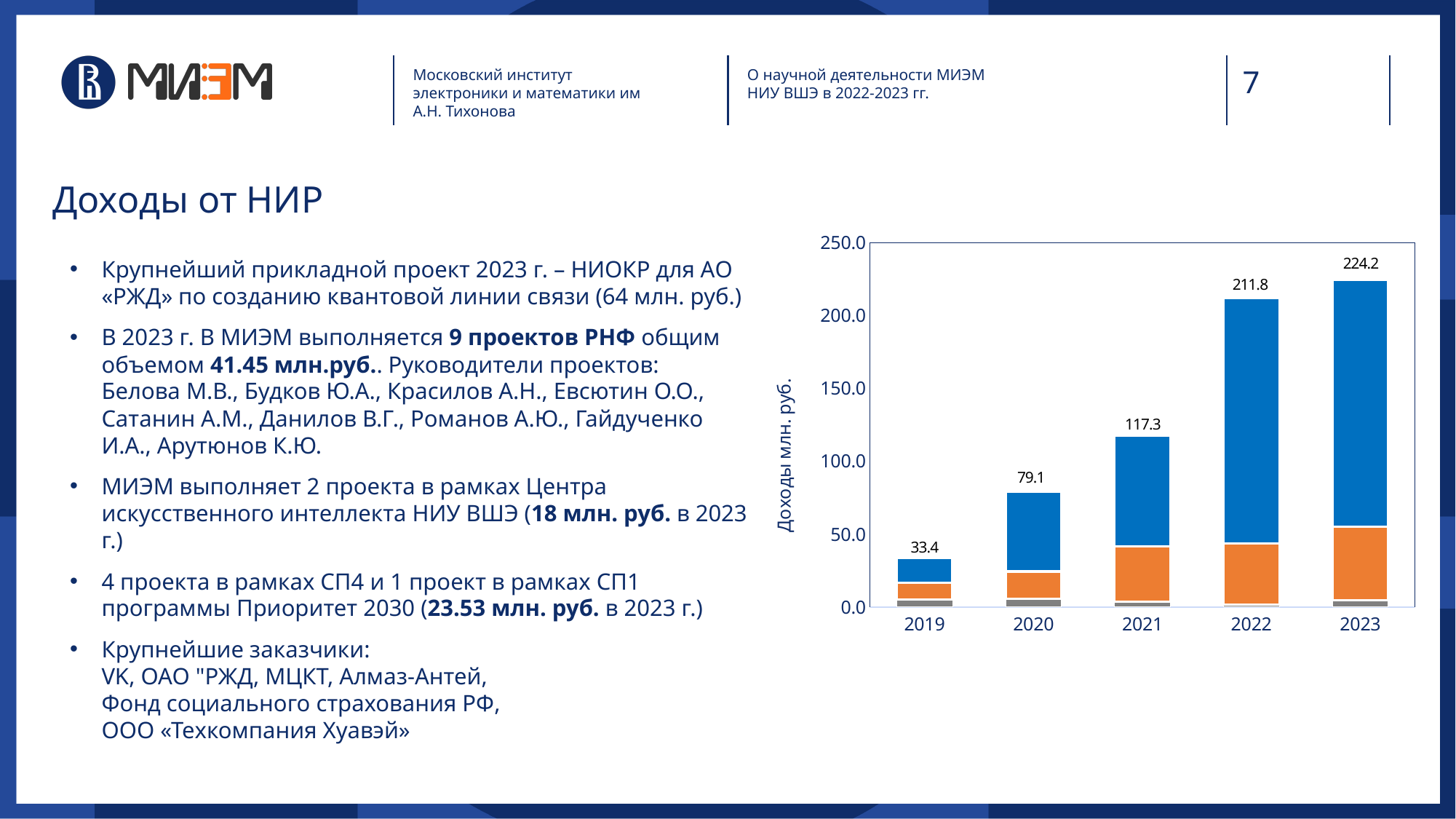
Which is larger, the total for 2020 or the total for 2021? 2021 What is the total value shown for 2023? 224.2 What is the total value shown for 2021? 117.3 Do the total values rise or fall from 2019 to 2023? Rise What is the difference between the totals for 2022 and 2021? 94.5 Which year has the lowest total income? 2019 Which year has the highest total income? 2023 What is the difference between the totals for 2023 and 2022? 12.4 How many years are shown on the x axis? 5 What kind of chart is shown on the slide? Stacked bar chart What is the label on the y axis of the chart? Доходы млн. руб. What is the total value shown for 2019? 33.4